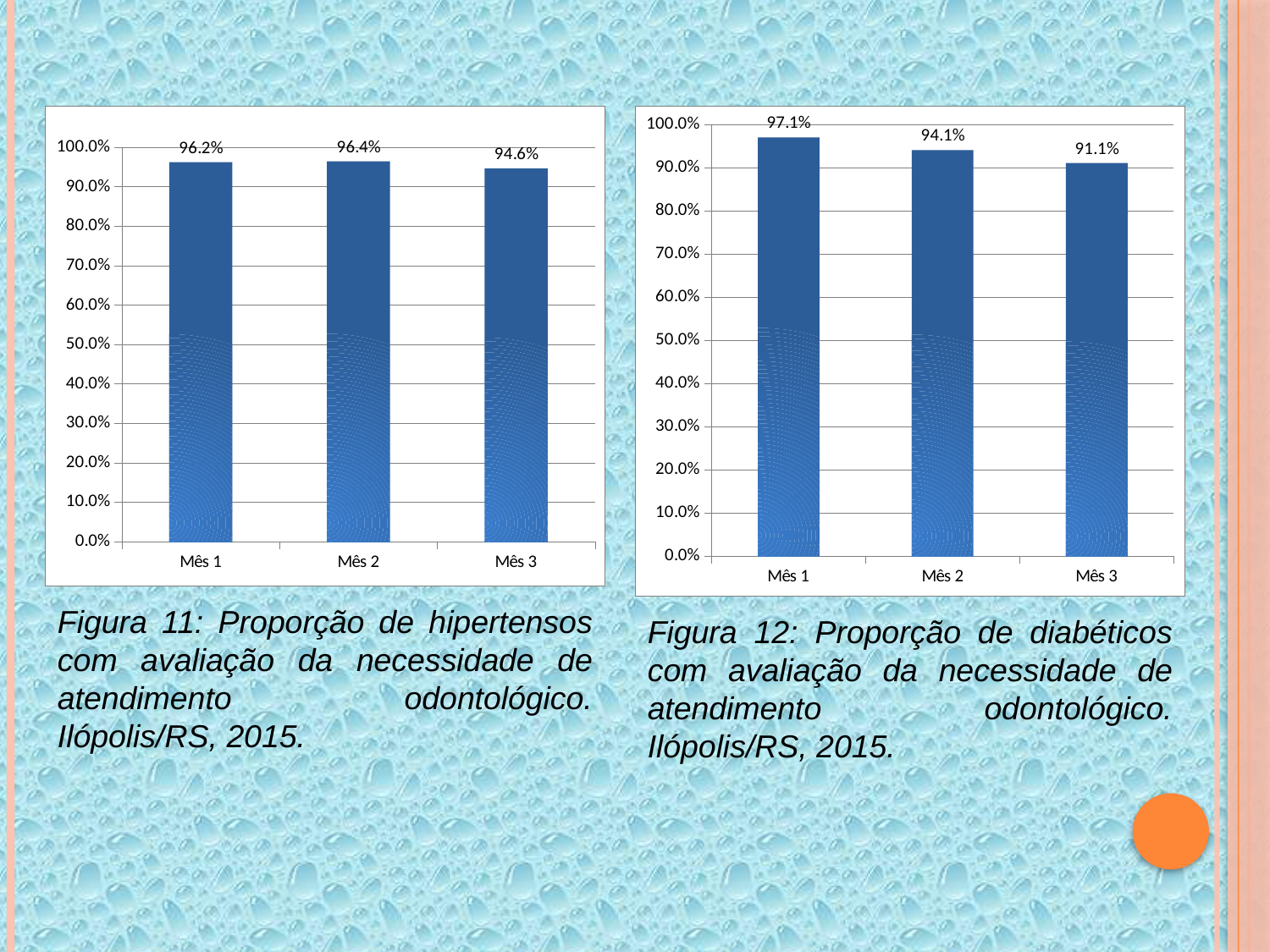
In the left chart (Figura 11, hipertensos), which month has the lowest value? Mês 3 In the left chart (Figura 11, hipertensos), how many months are shown? 3 In the right chart (Figura 12, diabéticos), do the values rise or fall from Mês 1 to Mês 3? fall In the left chart (Figura 11, hipertensos), what is the value for Mês 1? 96.2% In the right chart (Figura 12, diabéticos), what is the value for Mês 1? 97.1% In the right chart (Figura 12, diabéticos), is the value for Mês 3 greater or less than 90.0%? greater In the right chart (Figura 12, diabéticos), which month has the highest value? Mês 1 In the left chart (Figura 11, hipertensos), what is the value for Mês 3? 94.6% In the right chart (Figura 12, diabéticos), what is the difference between Mês 1 and Mês 3? 6.0% In the right chart (Figura 12, diabéticos), what is the value for Mês 2? 94.1% In the left chart (Figura 11, hipertensos), what is the difference between Mês 2 and Mês 3? 1.8% What kind of chart is the left chart (Figura 11)? bar chart